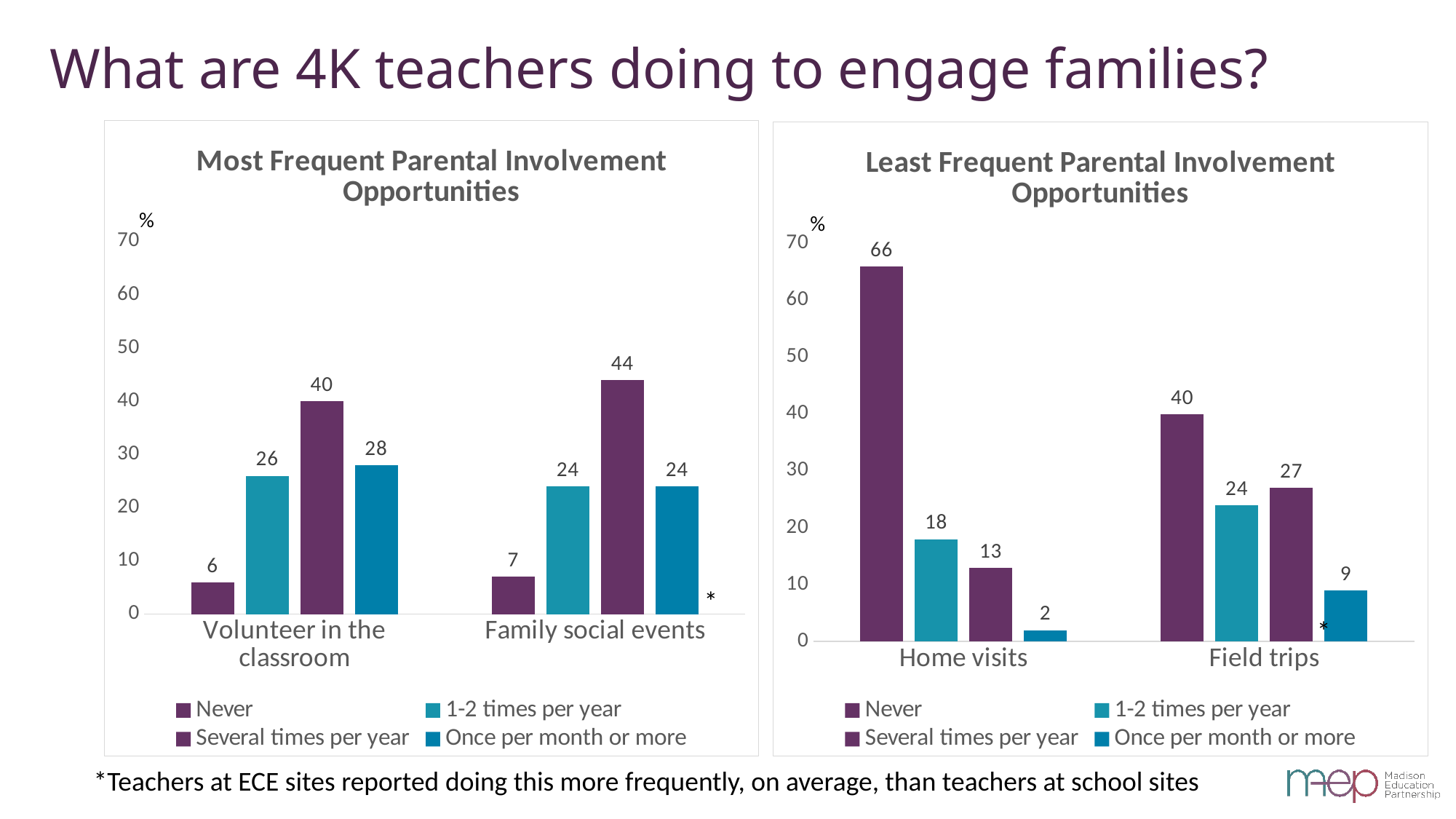
In the 'Least Frequent Parental Involvement Opportunities' chart, which series has the lowest value for Home visits? Once per month or more In the 'Least Frequent Parental Involvement Opportunities' chart, what is the difference between the 'Never' values for Home visits and Field trips? 26 How many series does the legend of the 'Most Frequent Parental Involvement Opportunities' chart list? 4 In the 'Least Frequent Parental Involvement Opportunities' chart, what is the value for 'Never' for Home visits? 66 In the 'Most Frequent Parental Involvement Opportunities' chart, is the '1-2 times per year' value larger for Volunteer in the classroom or for Family social events? Volunteer in the classroom How many categories are shown on the x axis of the 'Least Frequent Parental Involvement Opportunities' chart? 2 What kind of chart is the 'Least Frequent Parental Involvement Opportunities' chart? Bar chart In the 'Most Frequent Parental Involvement Opportunities' chart, what is the value for 'Several times per year' for Family social events? 44 In the 'Most Frequent Parental Involvement Opportunities' chart, which series has the highest value for Volunteer in the classroom? Several times per year In the 'Least Frequent Parental Involvement Opportunities' chart, is the 'Several times per year' value larger for Home visits or for Field trips? Field trips In the 'Least Frequent Parental Involvement Opportunities' chart, what is the value for 'Once per month or more' for Field trips? 9 In the 'Most Frequent Parental Involvement Opportunities' chart, what is the value for 'Never' for Volunteer in the classroom? 6